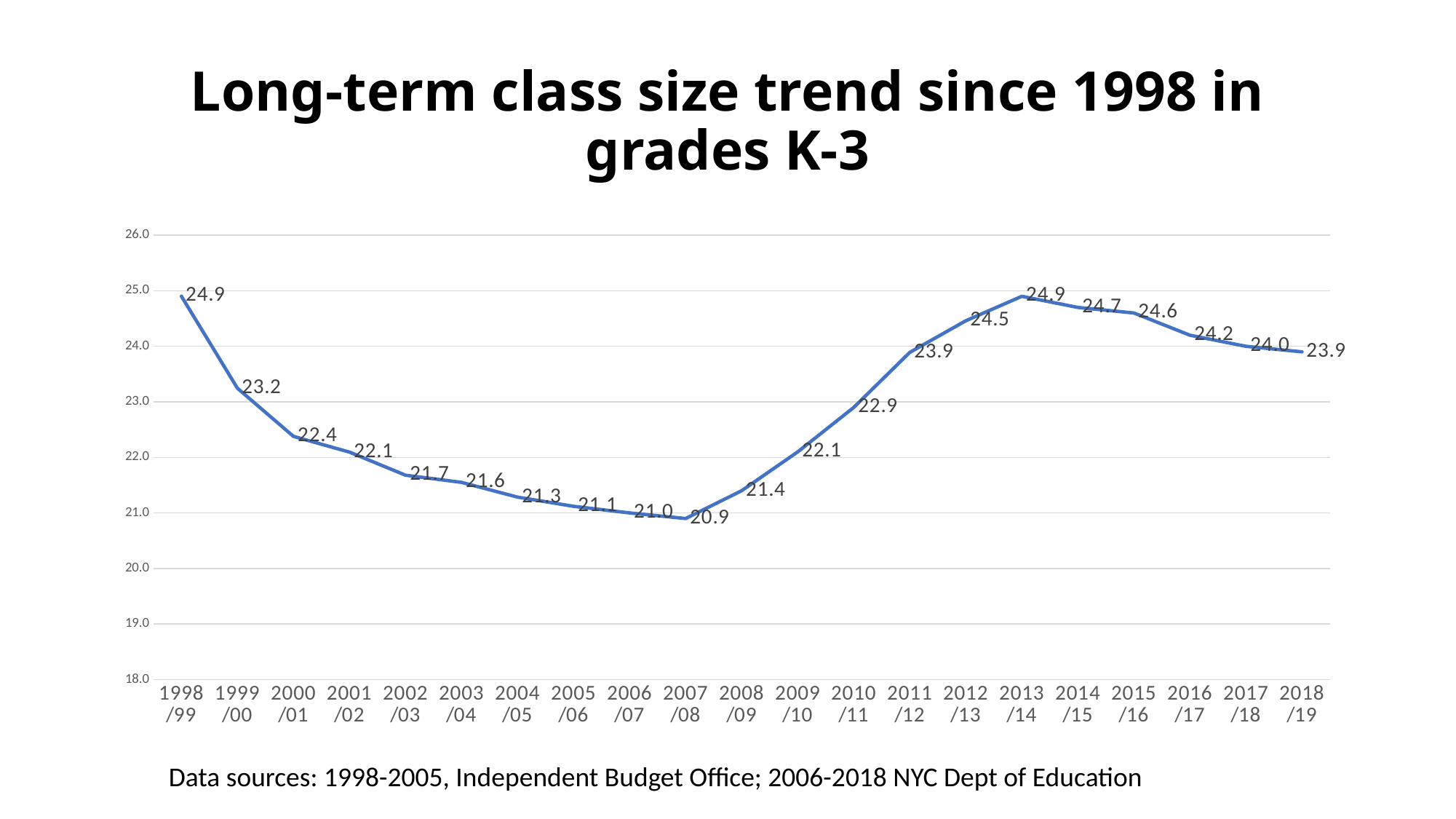
What is the class size value for 2007/08? 20.9 What is the class size value for 2013/14? 24.9 Does the class size rise or fall from 1998/99 to 2007/08? fall What is the class size value for 2018/19? 23.9 How many school years are plotted on the chart? 21 Which is larger, the class size in 2011/12 or in 2016/17? 2016/17 What is the class size value for 1998/99? 24.9 What type of chart is shown on the slide? line chart What is the difference between the class size in 2013/14 and in 2018/19? 1.0 Which school year has the lowest class size value? 2007/08 What is the difference between the class size in 1998/99 and in 2007/08? 4.0 What is the title of the chart? Long-term class size trend since 1998 in grades K-3